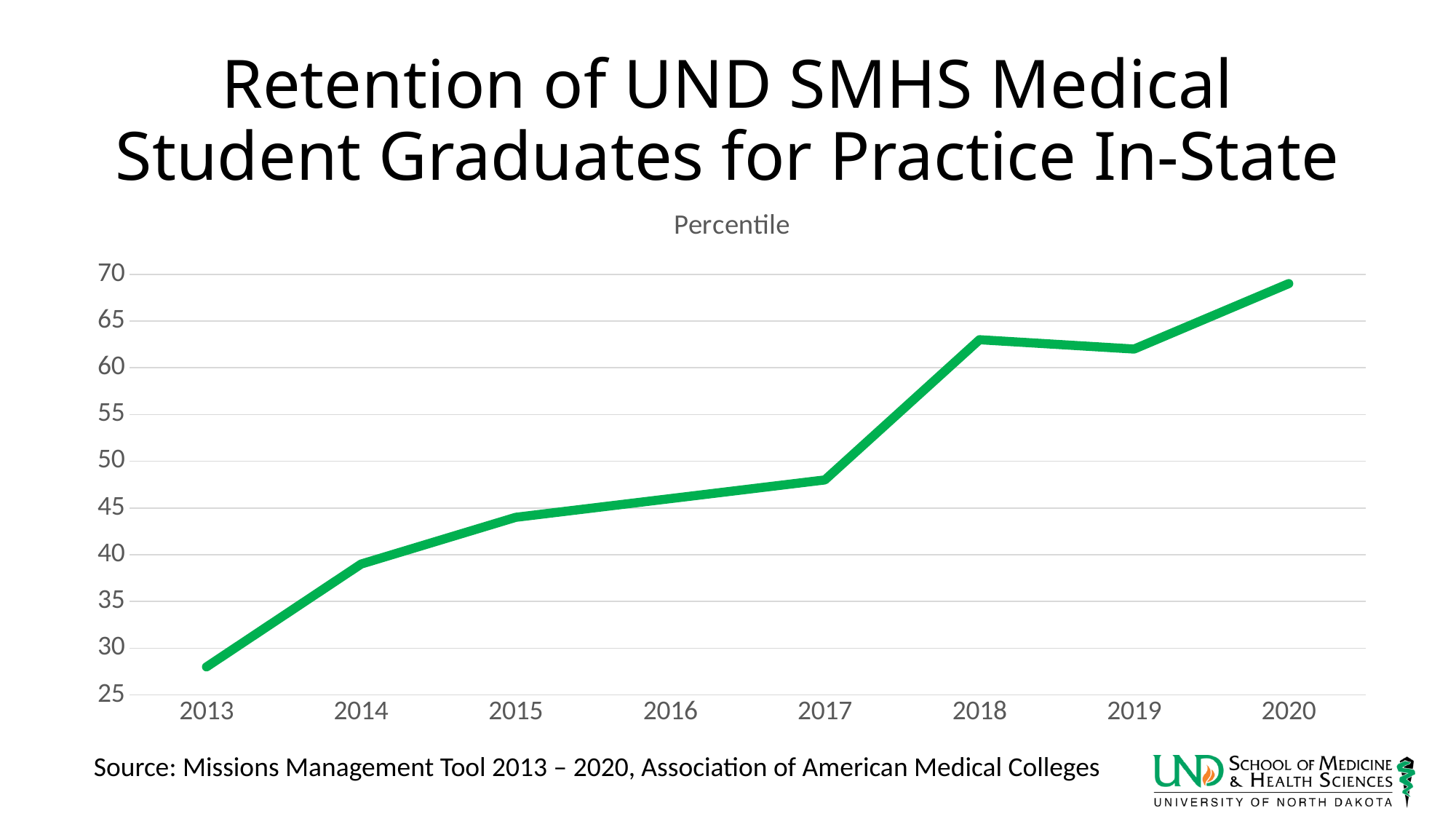
Is the value for 2020 greater or less than 65? greater Which year has the larger value, 2017 or 2018? 2018 Is the value for 2018 greater or less than 60? greater What is the label shown above the chart area, under the main title? Percentile Overall, do the values rise or fall from 2013 to 2020? rise Is the value for 2017 greater or less than 50? less Which year has the lowest percentile value? 2013 How many years are plotted along the x axis? 8 Which year has the highest percentile value? 2020 What kind of chart is shown on the slide? line chart